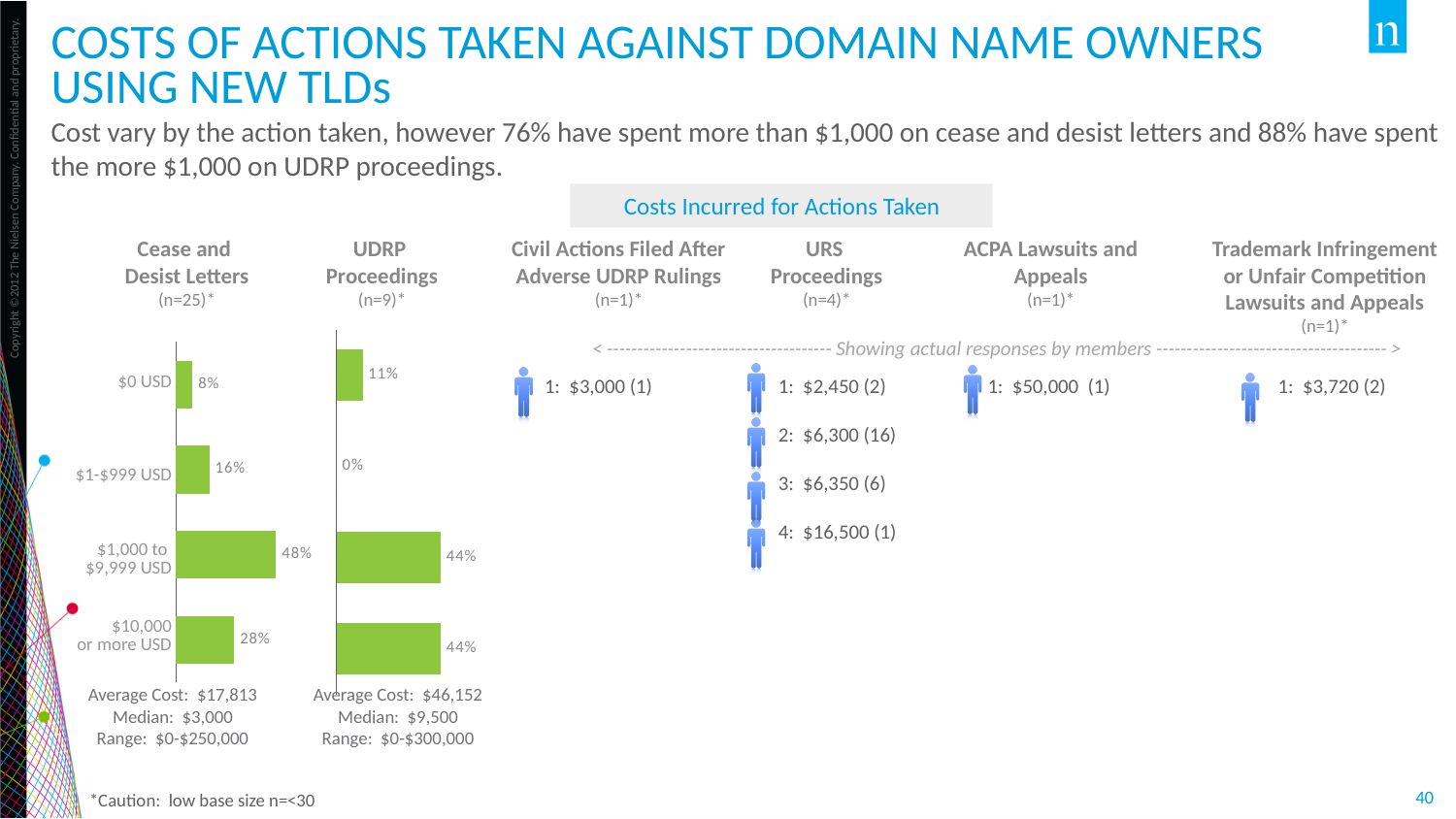
In the Cease and Desist Letters chart, what percentage spent $10,000 or more USD? 28% How many cost categories are shown in the Cease and Desist Letters chart? 4 In the Cease and Desist Letters chart, which cost category has the highest percentage? $1,000 to $9,999 USD In the Cease and Desist Letters chart, what percentage spent $1,000 to $9,999 USD? 48% In the UDRP Proceedings chart, what percentage spent $1-$999 USD? 0% Which is larger: the $10,000 or more USD percentage in the Cease and Desist Letters chart or in the UDRP Proceedings chart? UDRP Proceedings What is the base size (n) shown for the UDRP Proceedings chart? n=9 In the Cease and Desist Letters chart, which cost category has the lowest percentage? $0 USD In the Cease and Desist Letters chart, what is the difference between the $1,000 to $9,999 USD and $10,000 or more USD percentages? 20% In the UDRP Proceedings chart, which cost category has the lowest percentage? $1-$999 USD In the UDRP Proceedings chart, what percentage spent $0 USD? 11% What type of chart is used for the Cease and Desist Letters data? Bar chart